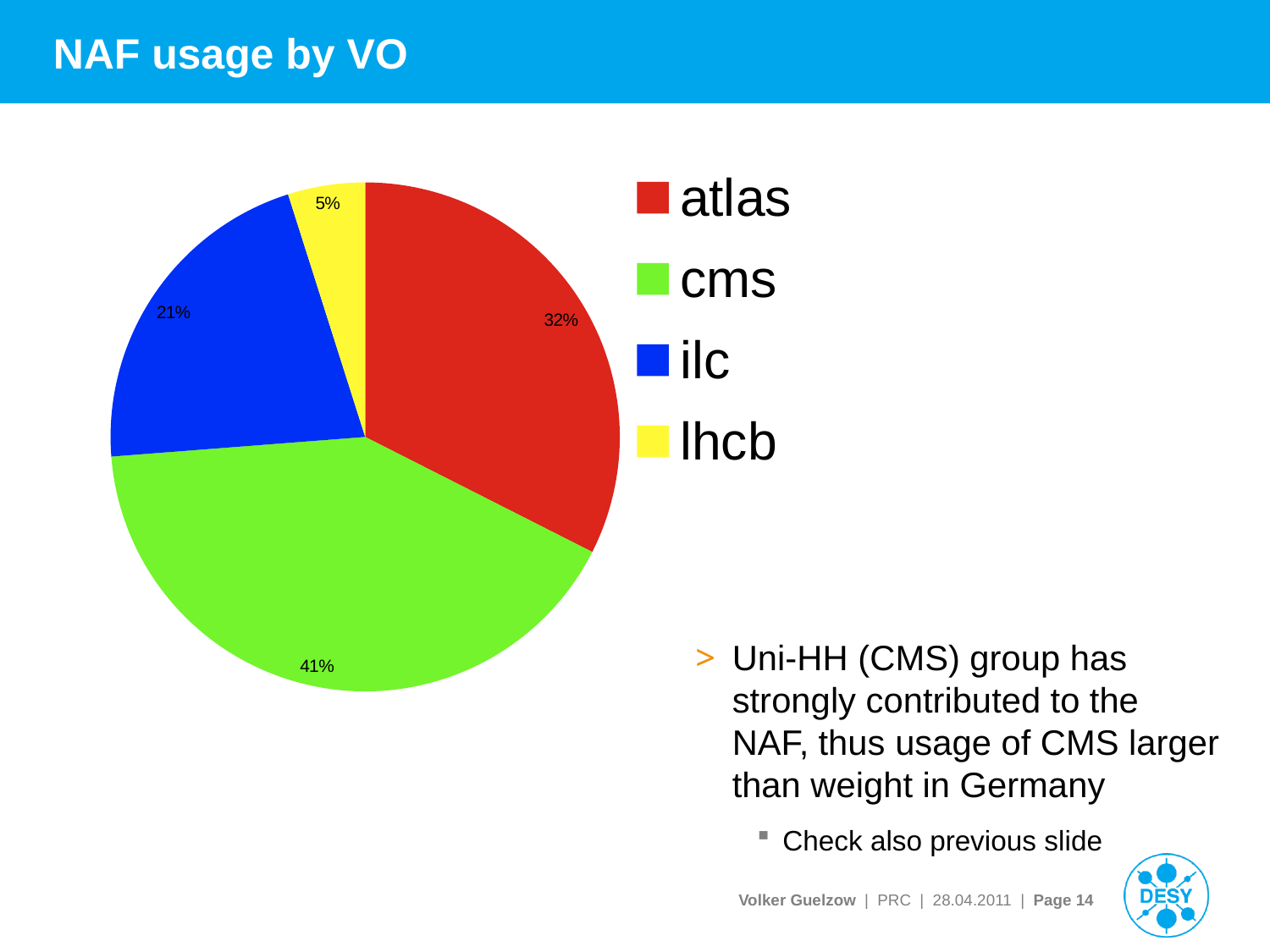
How many percentage points larger is the ilc share than the lhcb share? 16 What share of NAF usage does ilc have? 21% What share of NAF usage does atlas have? 32% Which VO has the smallest share of NAF usage? lhcb What share of NAF usage does cms have? 41% How many percentage points larger is the cms share than the atlas share? 9 Which VO has the largest share of NAF usage? cms How many VOs are shown in the pie chart? 4 What colour represents ilc in the pie chart? blue What kind of chart is shown on the slide? pie chart What share of NAF usage does lhcb have? 5% Which has a larger share of NAF usage, atlas or ilc? atlas